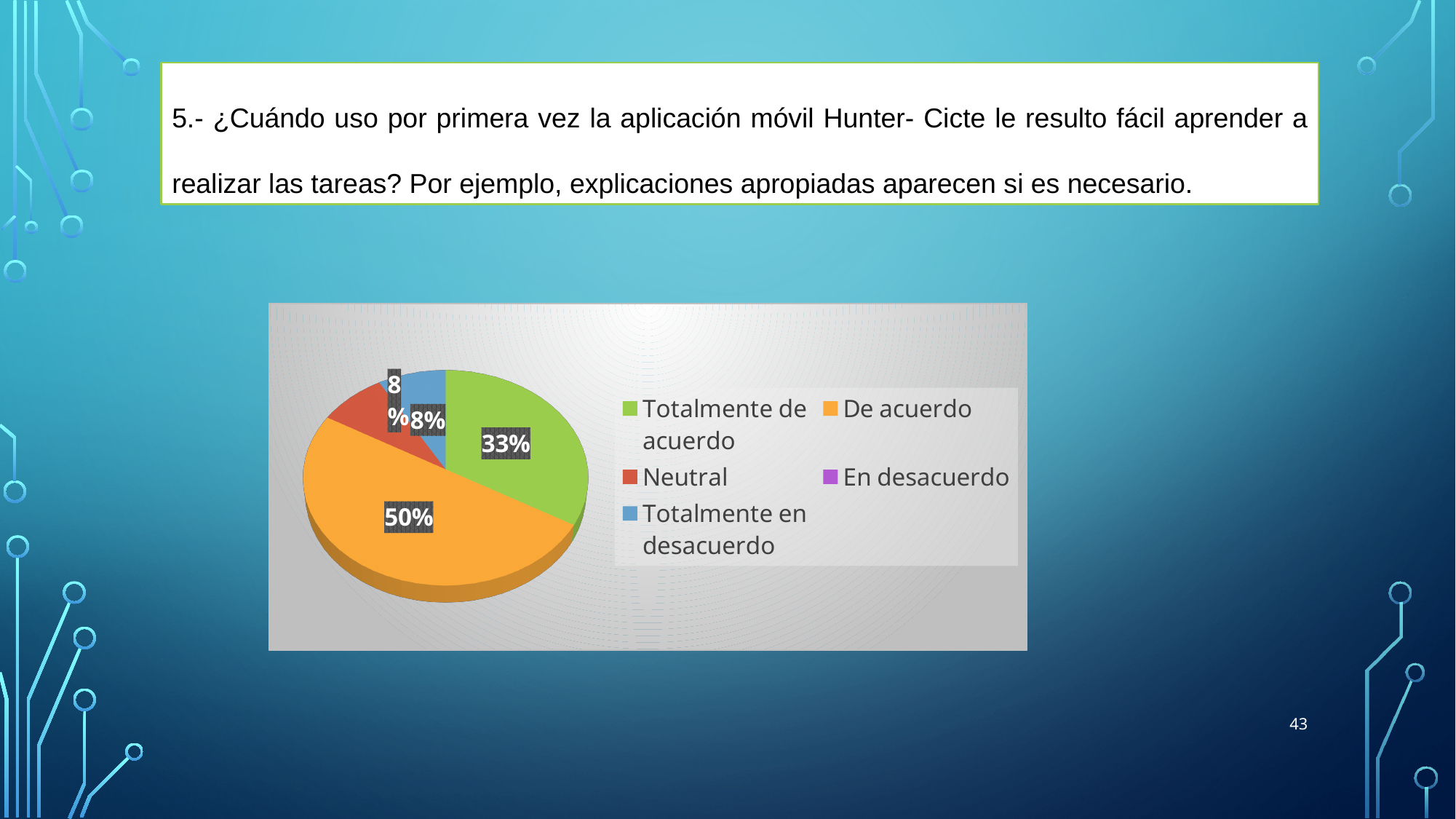
What kind of chart is shown on the slide? pie chart What colour is the "De acuerdo" slice in the pie chart? orange What percentage of the pie is labelled for "Totalmente en desacuerdo"? 8% What percentage of the pie is labelled for "Neutral"? 8% Which legend entry is shown in purple? En desacuerdo What percentage of the pie is labelled for "De acuerdo"? 50% What percentage of the pie is labelled for "Totalmente de acuerdo"? 33% Which slice is larger, "Totalmente de acuerdo" or "Neutral"? Totalmente de acuerdo How many categories does the legend of the pie chart list? 5 What share of the pie do "Neutral" and "Totalmente en desacuerdo" make up together? 16% What is the difference in percentage points between the "De acuerdo" slice and the "Totalmente de acuerdo" slice? 17 Which category has the largest slice of the pie? De acuerdo